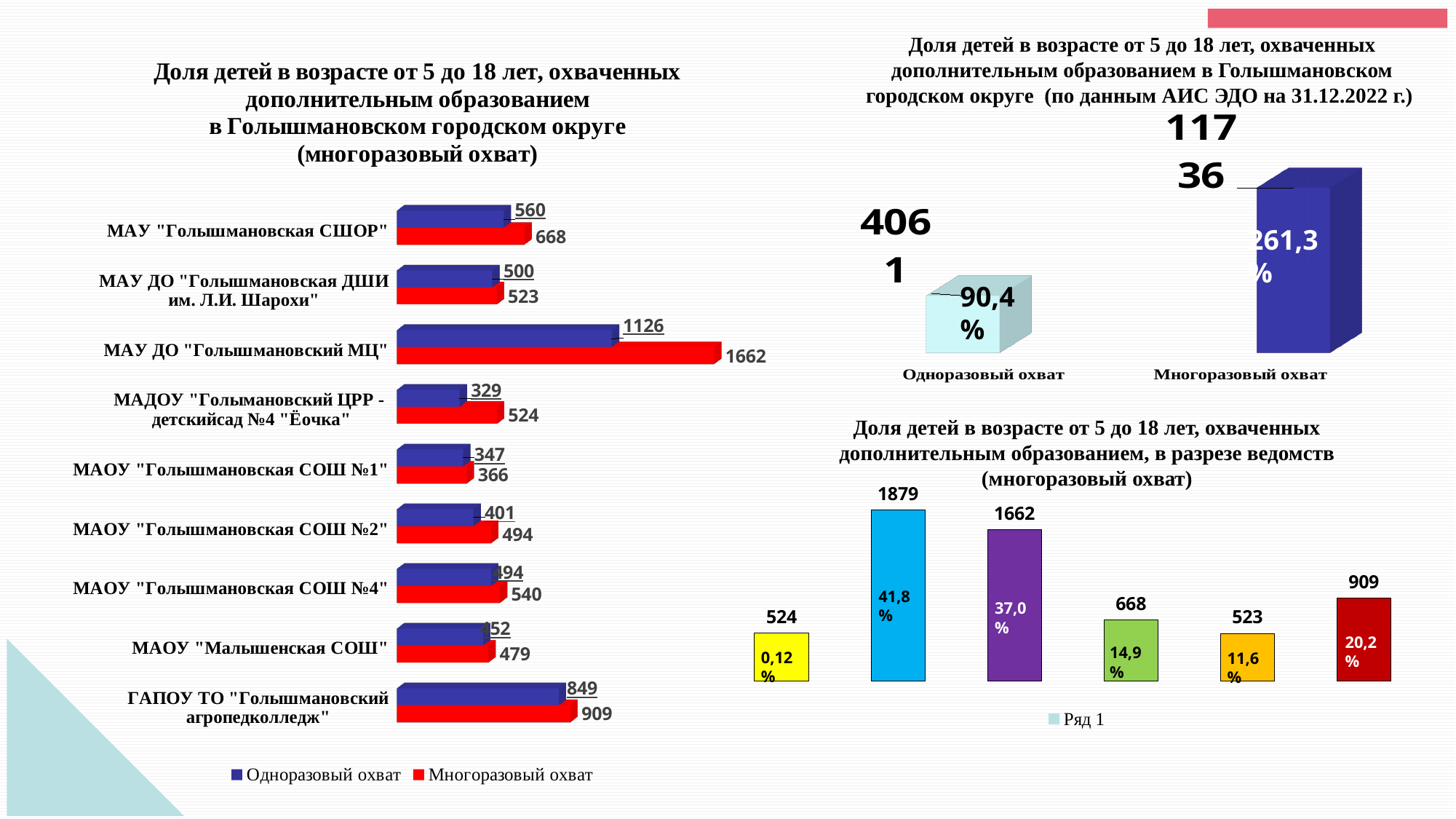
On the left chart, what is the value of Многоразовый охват for МАУ ДО "Голышмановский МЦ"? 1662 What kind of chart is the left chart? Bar chart On the top-right chart, which category has the larger value, Одноразовый охват or Многоразовый охват? Многоразовый охват On the top-right chart, what percentage is shown for Одноразовый охват? 90,4% On the bottom-right chart, what is the value of the tallest bar? 1879 On the bottom-right chart, how many bars are plotted? 6 On the left chart, what is the difference between Многоразовый охват and Одноразовый охват for МАУ ДО "Голышмановский МЦ"? 536 On the left chart, what is the value of Одноразовый охват for ГАПОУ ТО "Голышмановский агропедколледж"? 849 On the left chart, how many series does the legend list? 2 On the left chart, which institution has the lowest Многоразовый охват value? МАОУ "Голышмановская СОШ №1" On the left chart, how many institutions are listed? 9 On the left chart, which institution has the highest Многоразовый охват value? МАУ ДО "Голышмановский МЦ"